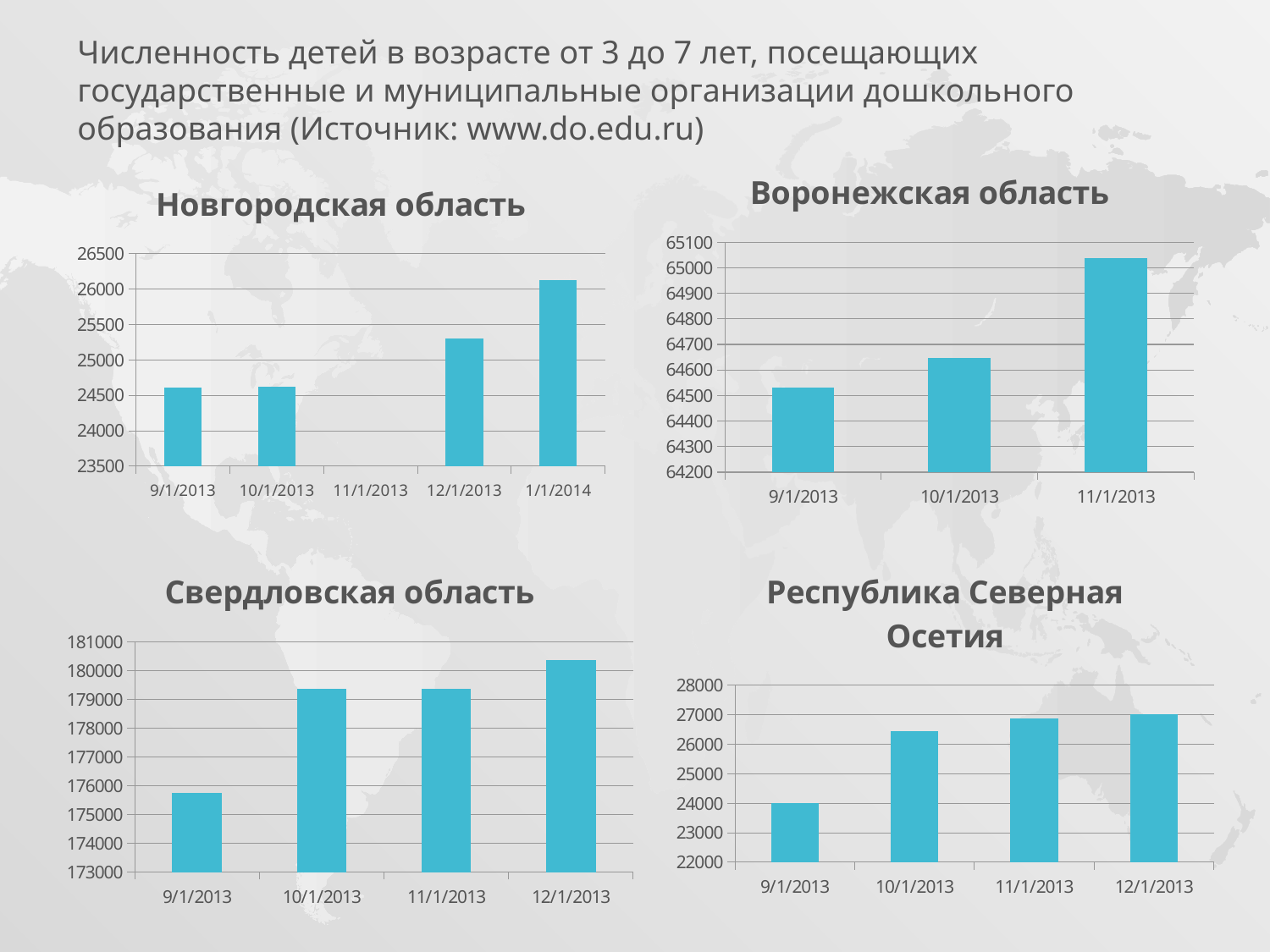
In the Воронежская область chart, do the values rise or fall from 9/1/2013 to 11/1/2013? rise In the Воронежская область chart, which date has the highest value? 11/1/2013 In the Воронежская область chart, which date has the lowest value? 9/1/2013 In the Свердловская область chart, which date has the highest value? 12/1/2013 In the Свердловская область chart, which date has the lowest value? 9/1/2013 In the Новгородская область chart, which is larger: the value for 12/1/2013 or the value for 9/1/2013? 12/1/2013 In the Новгородская область chart, is the value for 12/1/2013 greater or less than 25000? greater In the Свердловская область chart, is the value for 9/1/2013 greater or less than 176000? less What kind of chart is the Воронежская область chart? bar chart How many dates are shown on the x axis of the Воронежская область chart? 3 In the Воронежская область chart, is the value for 11/1/2013 greater or less than 64900? greater In the Республика Северная Осетия chart, which date has the lowest value? 9/1/2013